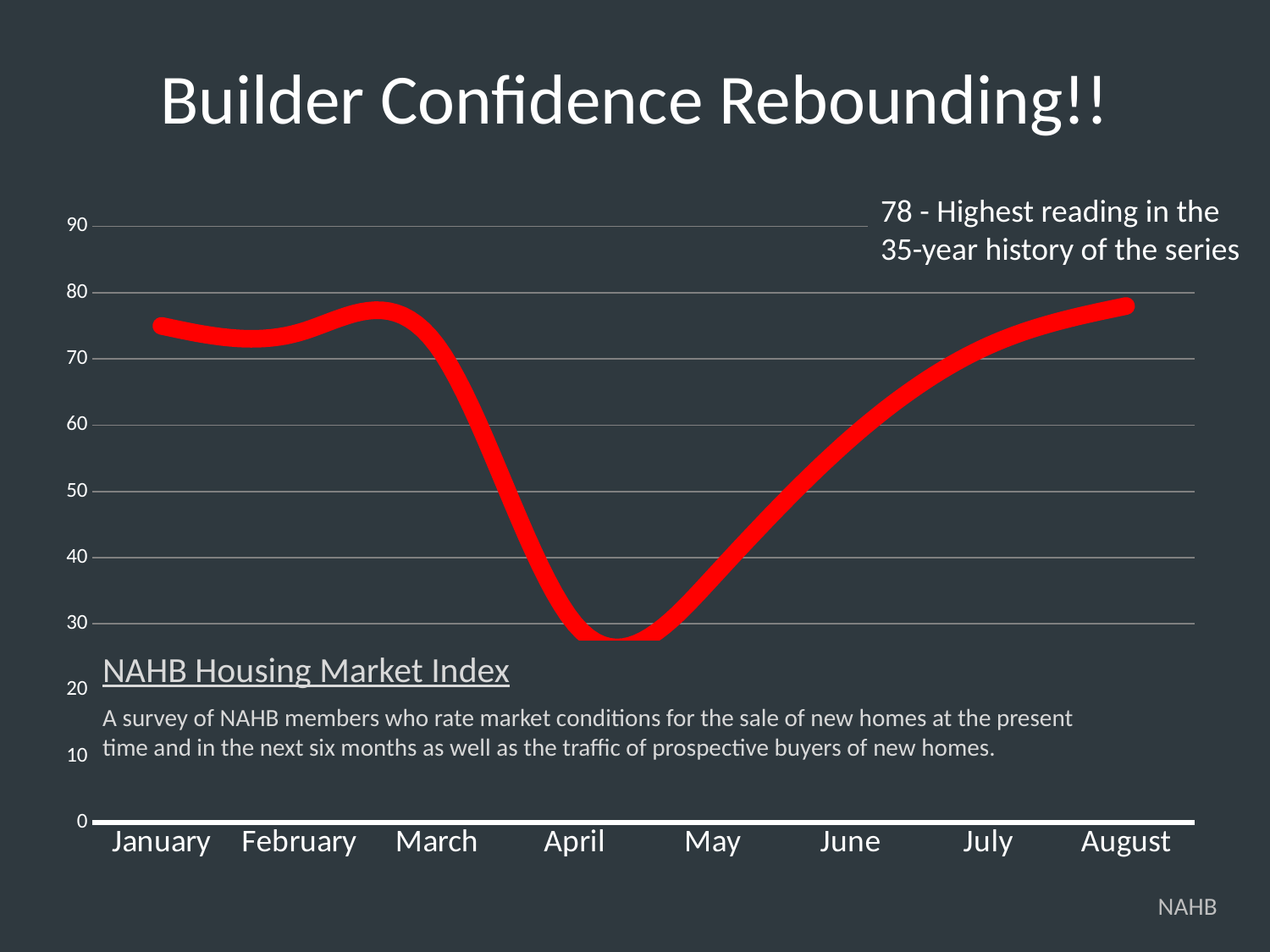
What kind of chart is shown on the slide? line chart Which month has the lowest value on the chart? April Is the value for April greater or less than 40? less How many months are plotted along the x axis? 8 What is the title of the slide containing the chart? Builder Confidence Rebounding!! What is the value for August, as stated in the annotation on the chart? 78 Is the value for January greater or less than 70? greater Is the value for June greater or less than 50? greater Which month has the highest value on the chart? August Which is larger, the value for March or the value for April? March Do the values rise or fall from April to August? rise